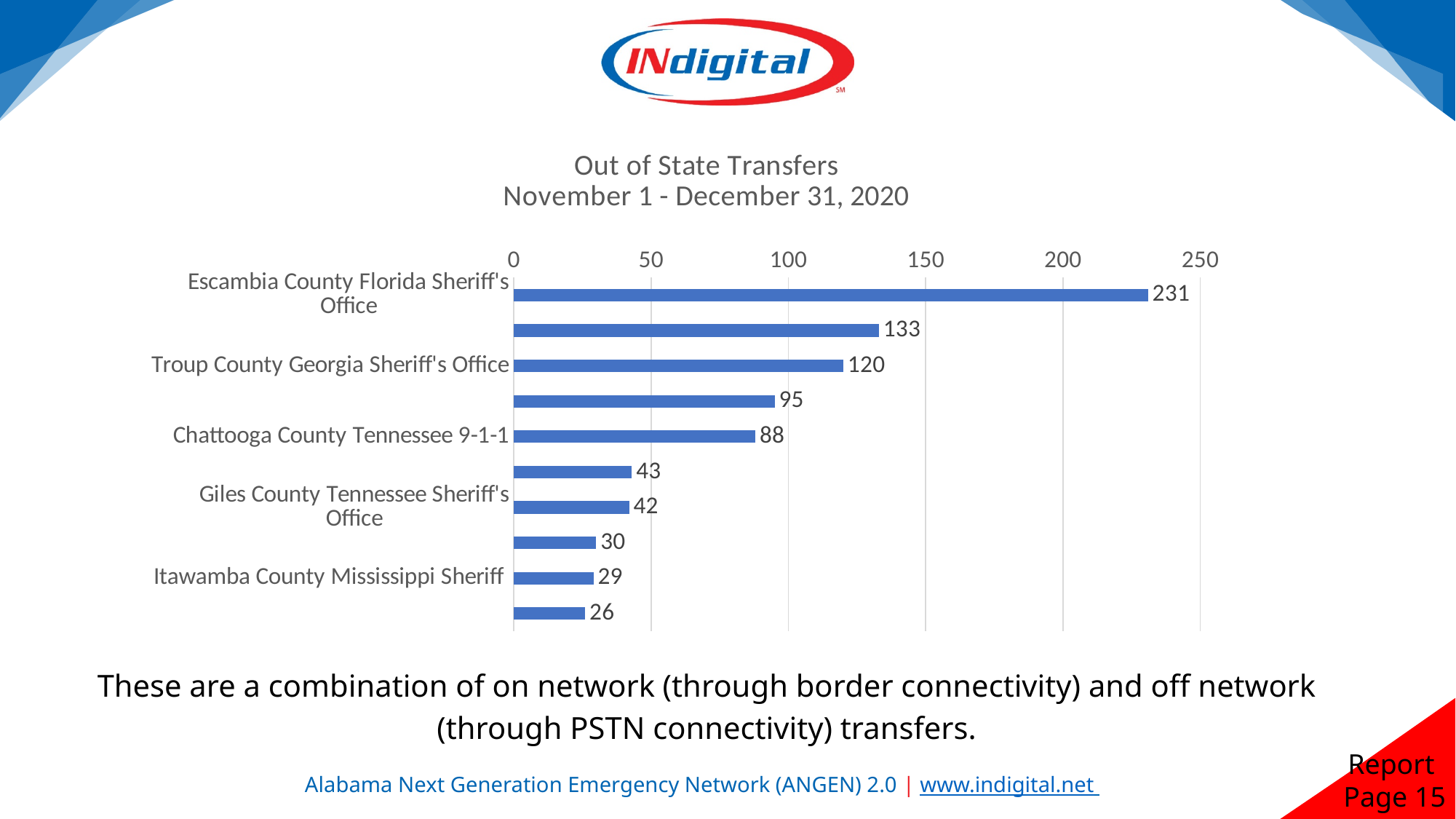
What is the value for Troup County Georgia Sheriff's Office? 120 What is the value for Escambia County Florida Sheriff's Office? 231 What is the value for Itawamba County Mississippi Sheriff? 29 How many bars are plotted in the chart? 10 Which is larger, the value for Chattooga County Tennessee 9-1-1 or the value for Giles County Tennessee Sheriff's Office? Chattooga County Tennessee 9-1-1 What kind of chart is shown on the slide? bar chart What is the difference between the values for Escambia County Florida Sheriff's Office and Troup County Georgia Sheriff's Office? 111 Which category has the highest value? Escambia County Florida Sheriff's Office What is the value for Giles County Tennessee Sheriff's Office? 42 What is the title of the chart? Out of State Transfers November 1 - December 31, 2020 What is the value for Chattooga County Tennessee 9-1-1? 88 What is the smallest value shown on any bar in the chart? 26